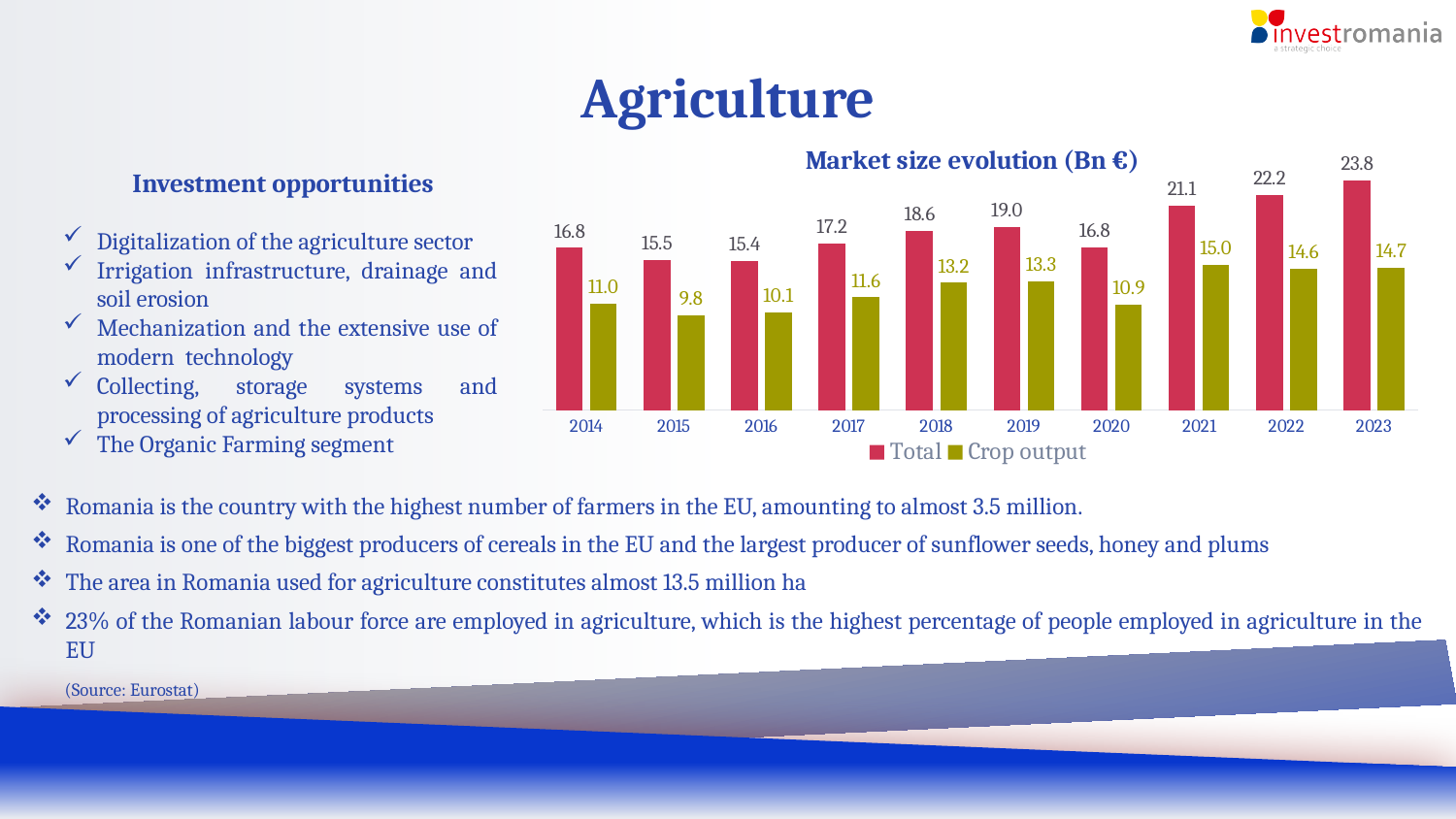
How many years are shown on the x axis of the chart? 10 What is the difference between the Total and Crop output values in 2019? 5.7 Does the Total value rise or fall from 2020 to 2023? rise What is the Total value for 2020? 16.8 Which year has the highest Total value? 2023 Which is larger, the Crop output in 2018 or the Crop output in 2022? 2022 What is the Crop output value for 2015? 9.8 What kind of chart is shown on the slide? bar chart What is the Total value for 2023 in the Market size evolution chart? 23.8 Which year has the lowest Crop output value? 2015 How many series does the legend list? 2 What is the title of the chart? Market size evolution (Bn €)